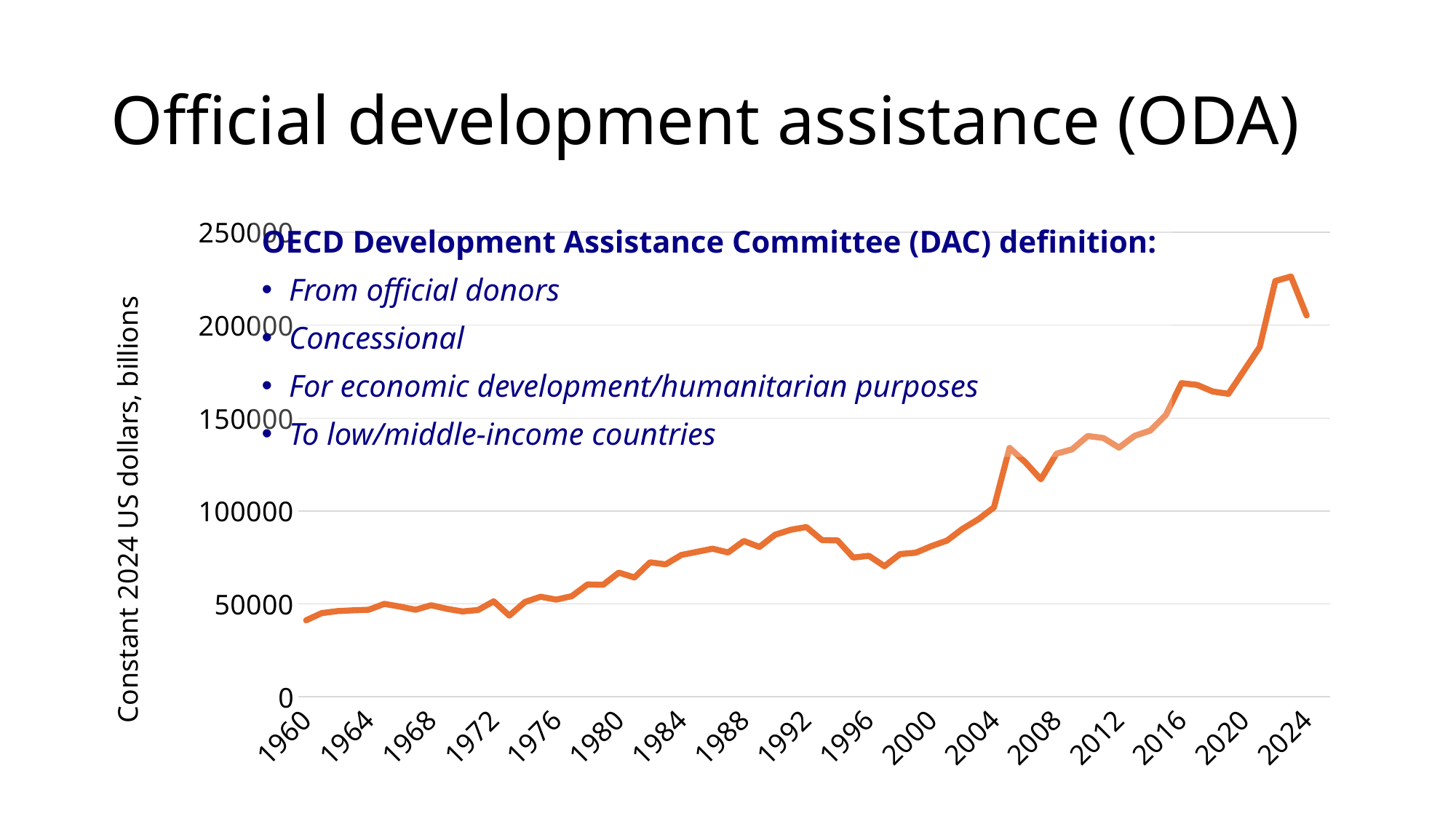
Is the value for 1980 greater or less than 50000? greater What is the label on the vertical axis of the chart? Constant 2024 US dollars, billions What kind of chart is shown on the slide? line chart Is the value for 2024 greater or less than 200000? greater Is the value for 2016 greater or less than 150000? greater Overall, do the values rise or fall from 1960 to 2024? rise How many lines (data series) are plotted on the chart? 1 How many year labels are shown on the horizontal axis? 17 Which of the two years has the larger value, 2004 or 2012? 2012